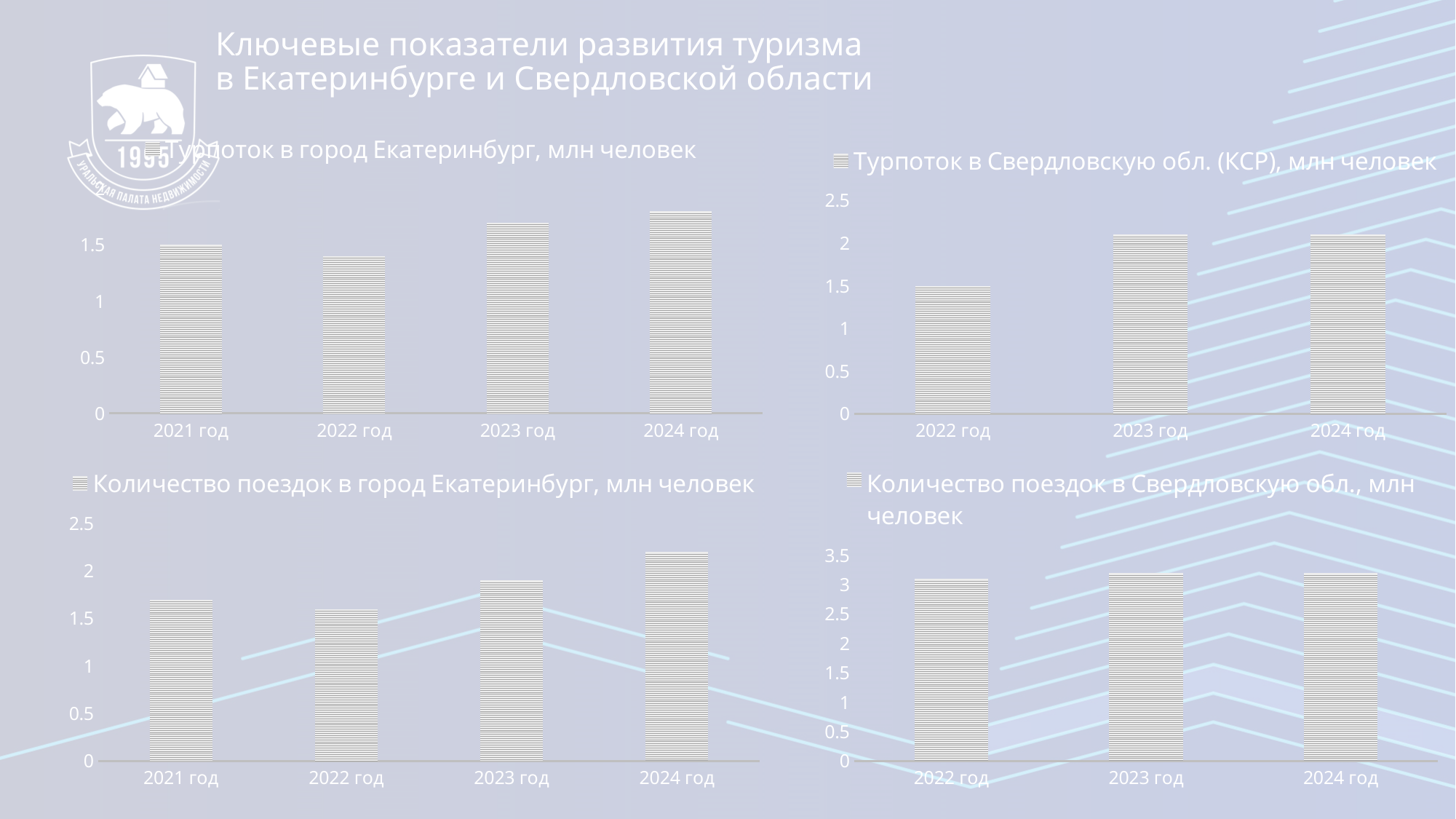
In the 'Количество поездок в Свердловскую обл., млн человек' chart, is the value for 2022 год greater or less than 2.5? greater In the 'Турпоток в город Екатеринбург, млн человек' chart, which year has the highest bar? 2024 год In the 'Количество поездок в город Екатеринбург, млн человек' chart, which year has the lowest bar? 2022 год In the 'Количество поездок в город Екатеринбург, млн человек' chart, is the value for 2024 год greater or less than 2? greater What kind of chart is the 'Турпоток в город Екатеринбург, млн человек' chart? bar chart In the 'Турпоток в город Екатеринбург, млн человек' chart, how many years are shown on the x axis? 4 In the 'Турпоток в город Екатеринбург, млн человек' chart, which is larger: the value for 2022 год or 2023 год? 2023 год In the 'Турпоток в Свердловскую обл. (КСР), млн человек' chart, which year has the lowest bar? 2022 год In the 'Турпоток в Свердловскую обл. (КСР), млн человек' chart, is the value for 2023 год greater or less than 2? greater In the 'Турпоток в город Екатеринбург, млн человек' chart, which year has the lowest bar? 2022 год In the 'Турпоток в Свердловскую обл. (КСР), млн человек' chart, how many years are shown on the x axis? 3 In the 'Количество поездок в город Екатеринбург, млн человек' chart, which year has the highest bar? 2024 год